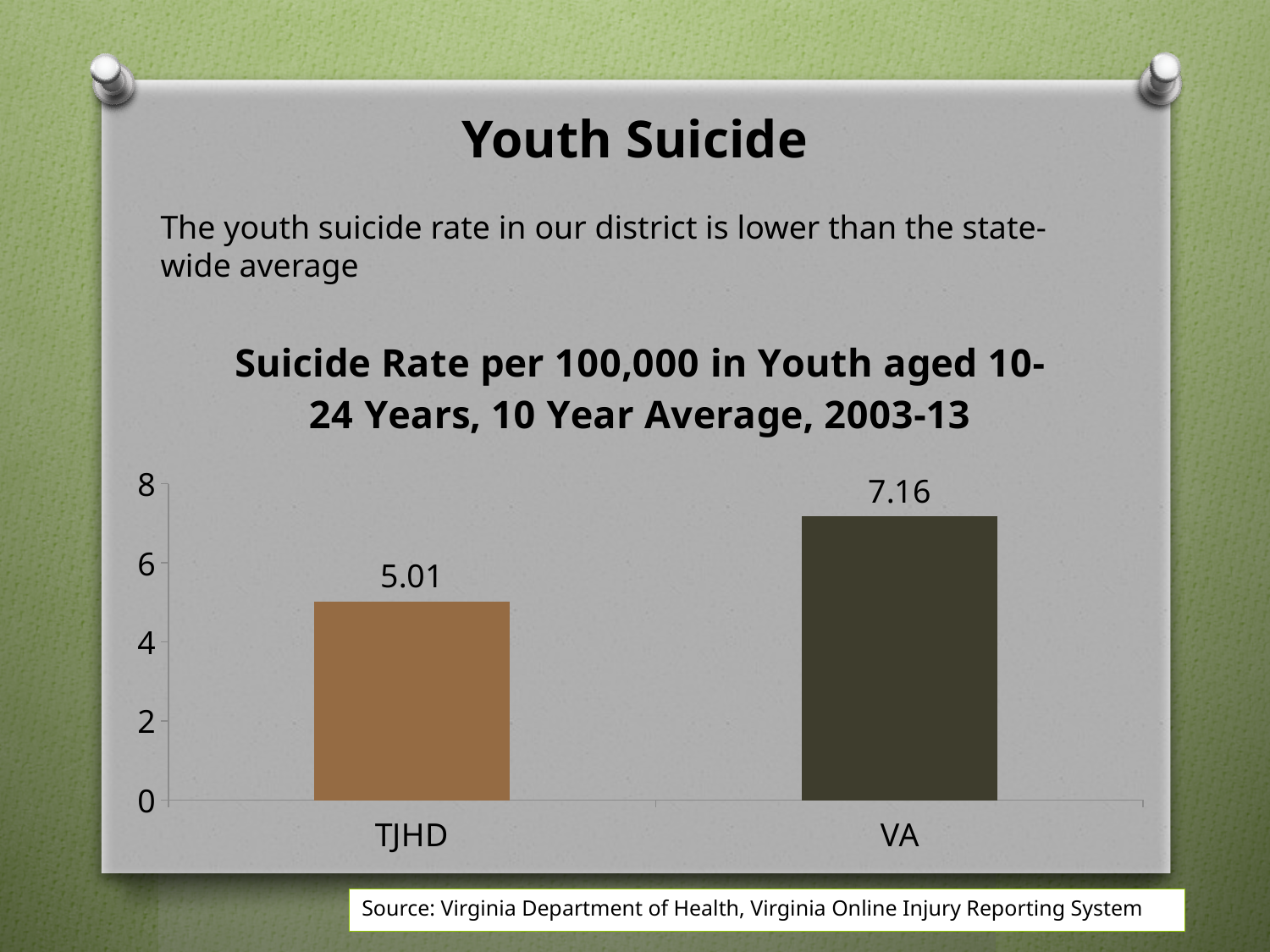
What is the suicide rate per 100,000 for TJHD? 5.01 What kind of chart is shown on the slide? Bar chart What is the title of the chart? Suicide Rate per 100,000 in Youth aged 10-24 Years, 10 Year Average, 2003-13 Is the value for TJHD greater or less than 6? less Which category has the highest value in the chart? VA Which category has the lowest value in the chart? TJHD What is the maximum value shown on the vertical axis? 8 What is the difference between the VA and TJHD suicide rates? 2.15 What is the suicide rate per 100,000 for VA? 7.16 Is the value for VA greater or less than 6? greater How many categories are shown in the chart? 2 Which category has the higher suicide rate, TJHD or VA? VA